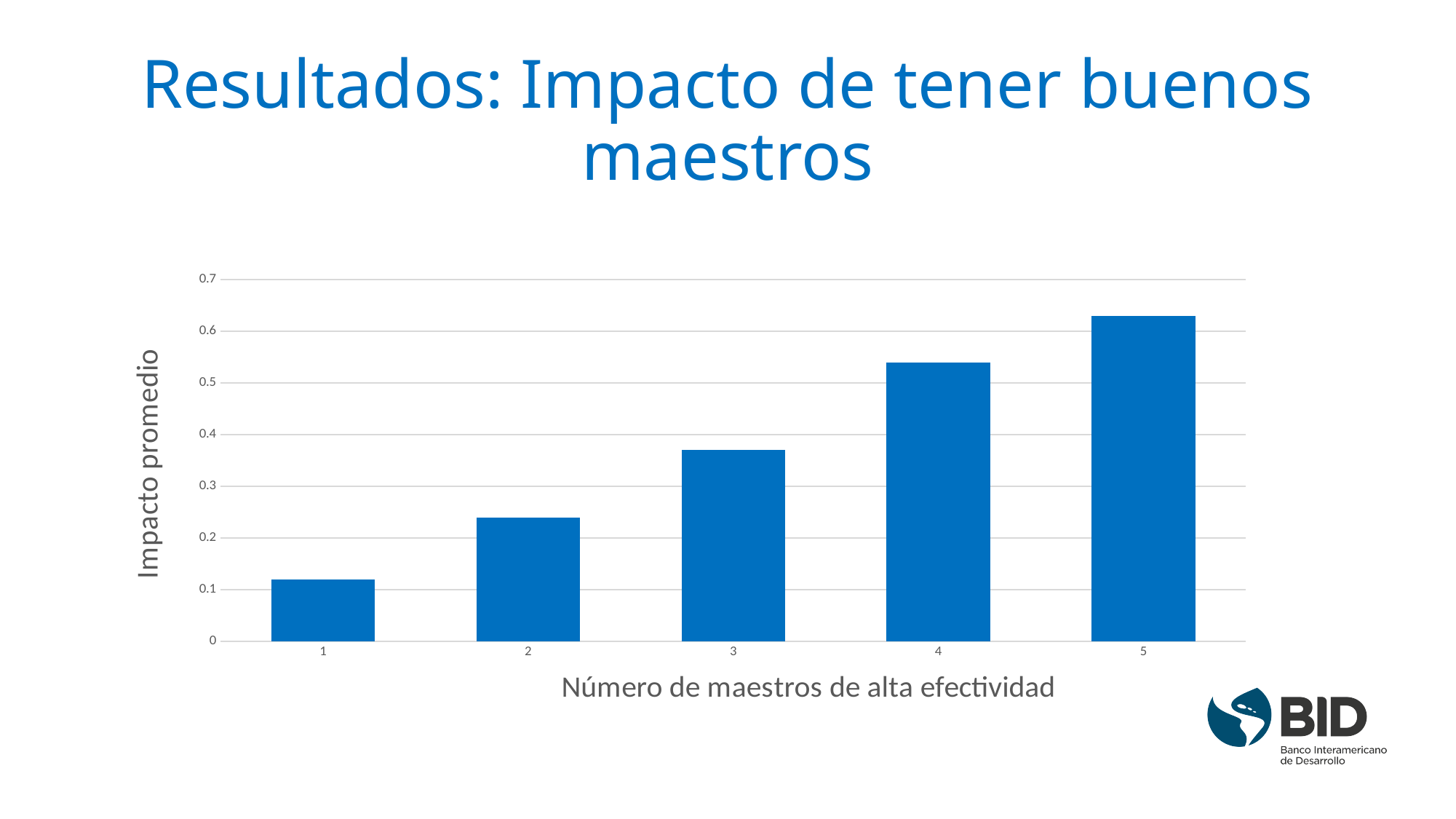
Is the value for 3 high-effectiveness teachers greater or less than 0.4? less How many bars (categories) does the chart show? 5 Which number of high-effectiveness teachers has the highest average impact? 5 What is the label of the x axis? Número de maestros de alta efectividad Is the value for 4 high-effectiveness teachers greater or less than 0.5? greater Is the value for 5 high-effectiveness teachers greater or less than 0.6? greater What is the label of the y axis? Impacto promedio Which number of high-effectiveness teachers has the lowest average impact? 1 What kind of chart is shown on the slide? bar chart Do the values rise or fall as the number of high-effectiveness teachers increases along the x axis? rise Which has a larger average impact: 2 or 4 high-effectiveness teachers? 4